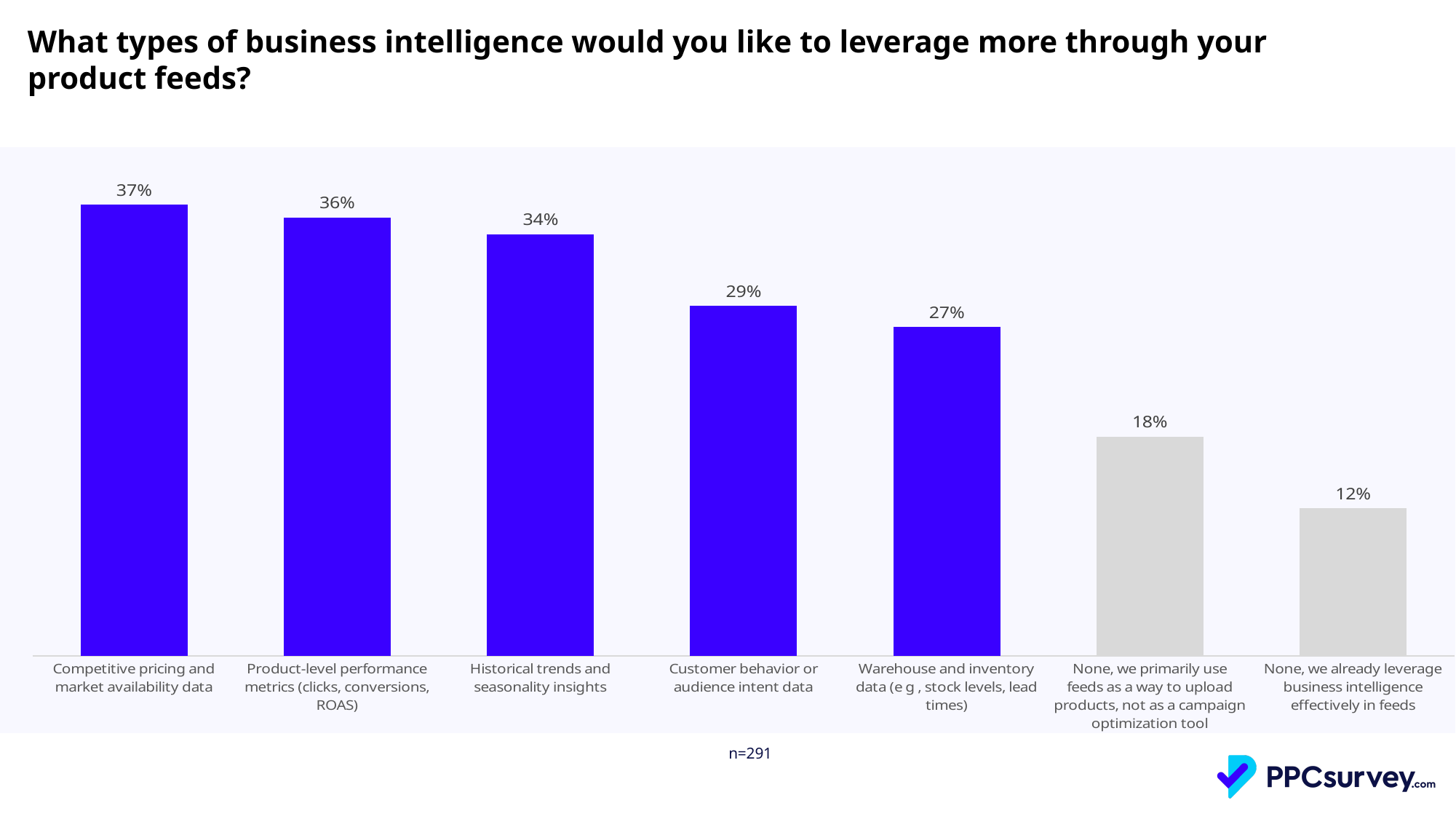
How many categories are shown in the chart? 7 What is the value for 'Historical trends and seasonality insights'? 34% What kind of chart is shown on the slide? Bar chart What percentage is shown for 'Customer behavior or audience intent data'? 29% What is the difference between 'Product-level performance metrics (clicks, conversions, ROAS)' and 'Warehouse and inventory data (e g , stock levels, lead times)'? 9% What percentage of respondents chose 'Competitive pricing and market availability data'? 37% Which category has the lowest value? None, we already leverage business intelligence effectively in feeds Which category has the highest value? Competitive pricing and market availability data Which is larger: 'Customer behavior or audience intent data' or 'None, we primarily use feeds as a way to upload products, not as a campaign optimization tool'? Customer behavior or audience intent data What is the value for 'None, we already leverage business intelligence effectively in feeds'? 12% What is the sample size (n) noted below the chart? n=291 Do the values rise or fall from left to right across the categories? Fall